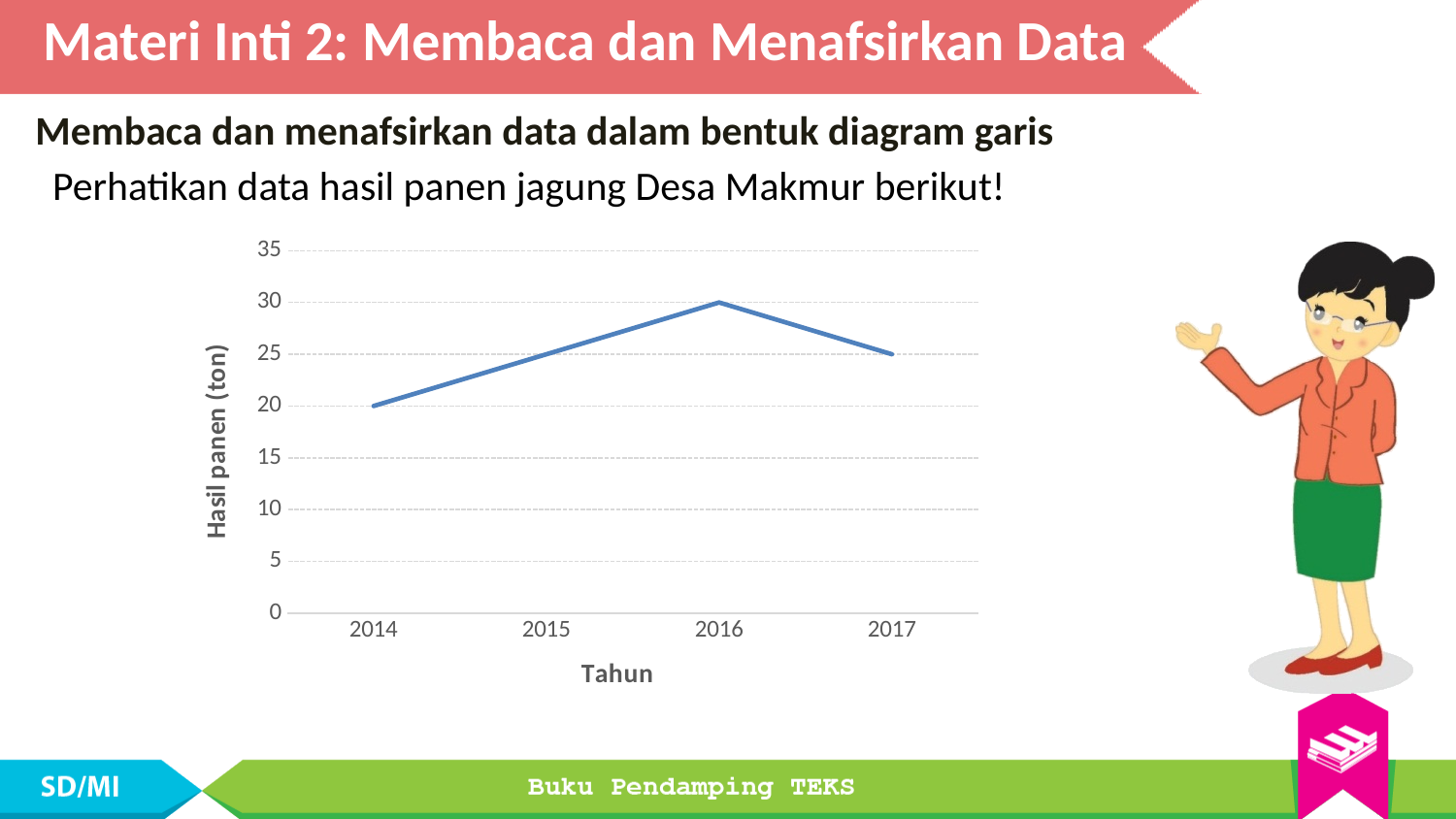
What is the harvest value (Hasil panen) for 2014? 20 How many years are plotted on the x axis? 4 What is the harvest value (Hasil panen) for 2016? 30 Which year has the highest harvest value? 2016 What is the title of the vertical axis? Hasil panen (ton) Is the value for 2017 greater or less than 20? greater What is the difference between the harvest values for 2016 and 2014? 10 What kind of chart is shown on the slide? line chart Do the values rise or fall from 2014 to 2016? rise Which year has the lowest harvest value? 2014 Which year has a larger harvest value, 2015 or 2016? 2016 What is the harvest value (Hasil panen) for 2017? 25